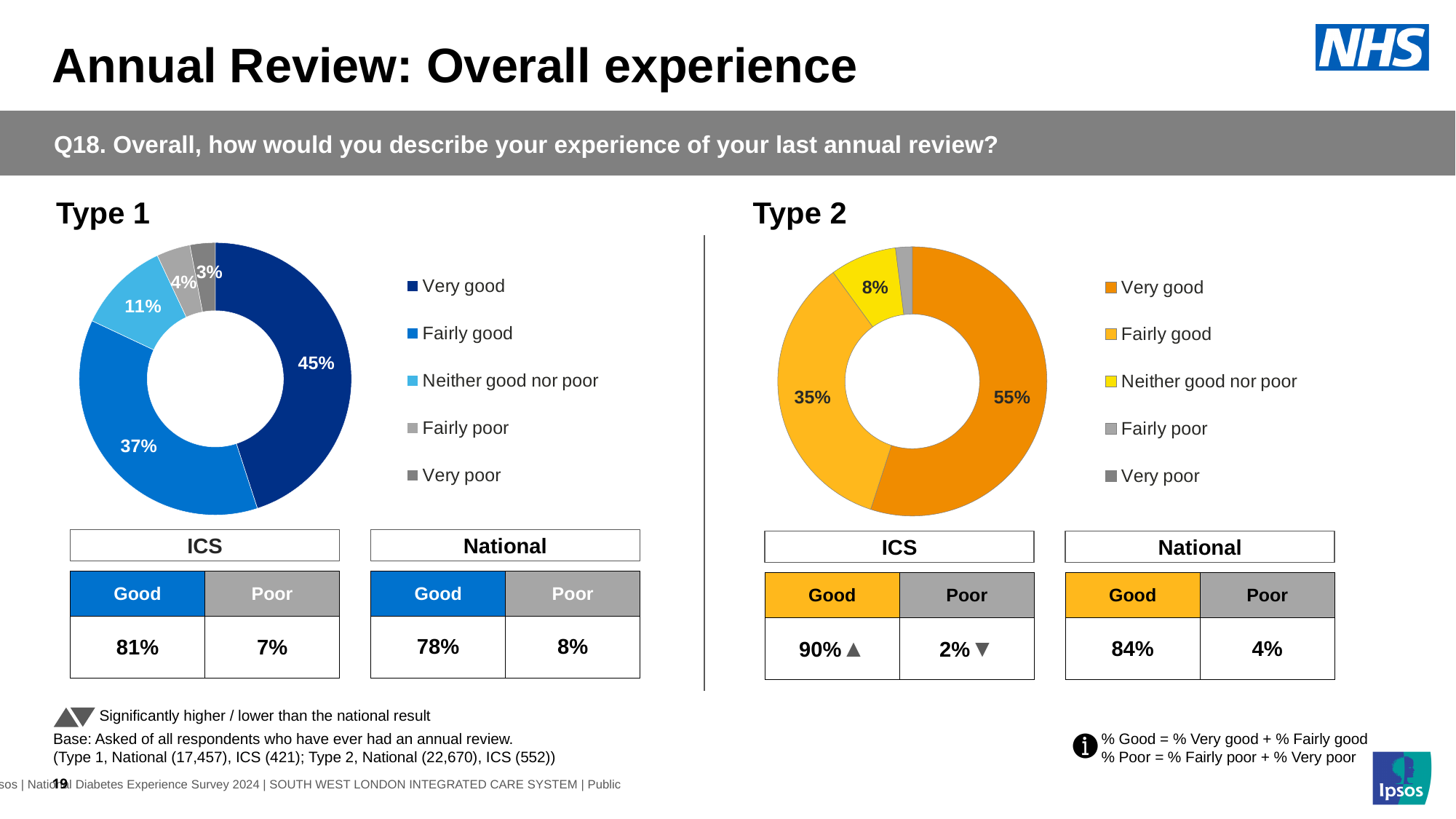
In the Type 1 chart, which labelled response category has the smallest share? Very poor In the Type 2 chart, what percentage of respondents said their experience was 'Fairly good'? 35% In the Type 2 chart, what is the difference between the 'Very good' and 'Fairly good' shares? 20% In the Type 1 chart, what percentage of respondents said their experience was 'Very good'? 45% In the Type 1 chart, which response category has the largest share? Very good In the Type 1 chart, what percentage of respondents said 'Neither good nor poor'? 11% In the Type 1 chart, what is the difference between the 'Very good' and 'Fairly good' shares? 8% How many response categories does the legend of the Type 1 chart list? 5 What type of chart is used to show the Type 2 results? Donut (pie) chart In the Type 2 chart, what percentage of respondents said 'Neither good nor poor'? 8% In the Type 2 chart, which response category has the largest share? Very good Which chart has the larger 'Very good' share, Type 1 or Type 2? Type 2